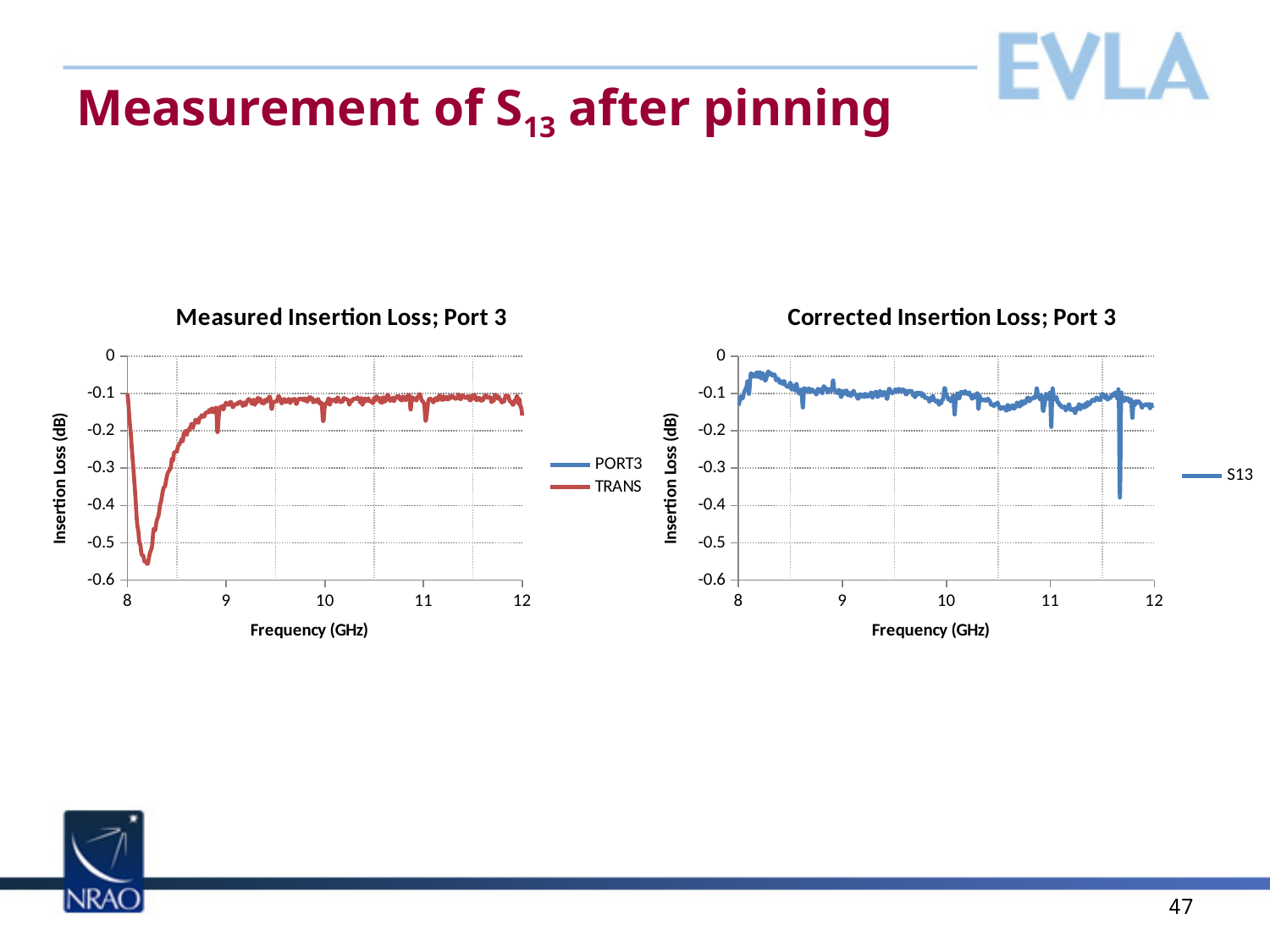
In the "Measured Insertion Loss; Port 3" chart, is the TRANS value at 10 GHz greater or less than -0.2? greater In the "Corrected Insertion Loss; Port 3" chart, how many labelled tick marks are on the Frequency (GHz) axis? 5 What kind of chart is the "Corrected Insertion Loss; Port 3" chart? line chart In the "Measured Insertion Loss; Port 3" chart, is the lowest value of the TRANS line greater or less than -0.5? less In the "Corrected Insertion Loss; Port 3" chart, is the S13 value at 10 GHz greater or less than -0.2? greater In the "Measured Insertion Loss; Port 3" chart, what are the two legend entries? PORT3 and TRANS In the "Measured Insertion Loss; Port 3" chart, does the TRANS line rise or fall between 8.2 GHz and 9 GHz? rise How many series does the legend of the "Corrected Insertion Loss; Port 3" chart list? 1 How many series does the legend of the "Measured Insertion Loss; Port 3" chart list? 2 In the "Corrected Insertion Loss; Port 3" chart, what is the label on the y axis? Insertion Loss (dB) What kind of chart is the "Measured Insertion Loss; Port 3" chart? line chart